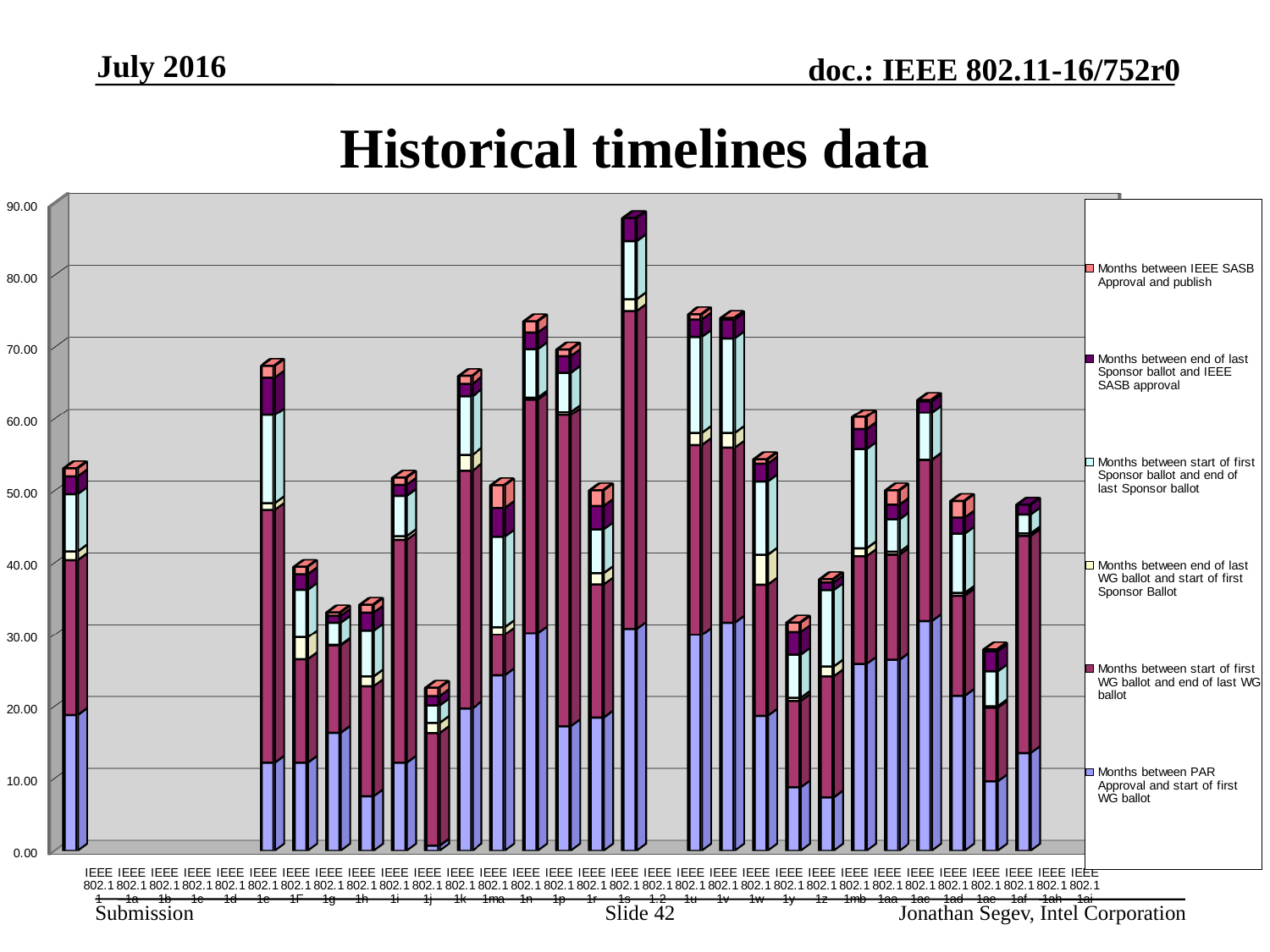
What is the title of the chart? Historical timelines data Is the total for IEEE 802.11j greater or less than 30? less Which is taller, the bar for IEEE 802.11n or the bar for IEEE 802.11g? IEEE 802.11n Is the total for the first bar (IEEE 802.11) greater or less than 60? less Is the total for the tallest bar (IEEE 802.11s) greater or less than 80? greater What is the highest value shown on the vertical axis? 90.00 What kind of chart is shown on the slide? Stacked bar chart Which category has the tallest stacked bar? IEEE 802.11s Which legend entry corresponds to the bottom segment of each stacked bar? Months between PAR Approval and start of first WG ballot How many series does the legend list? 6